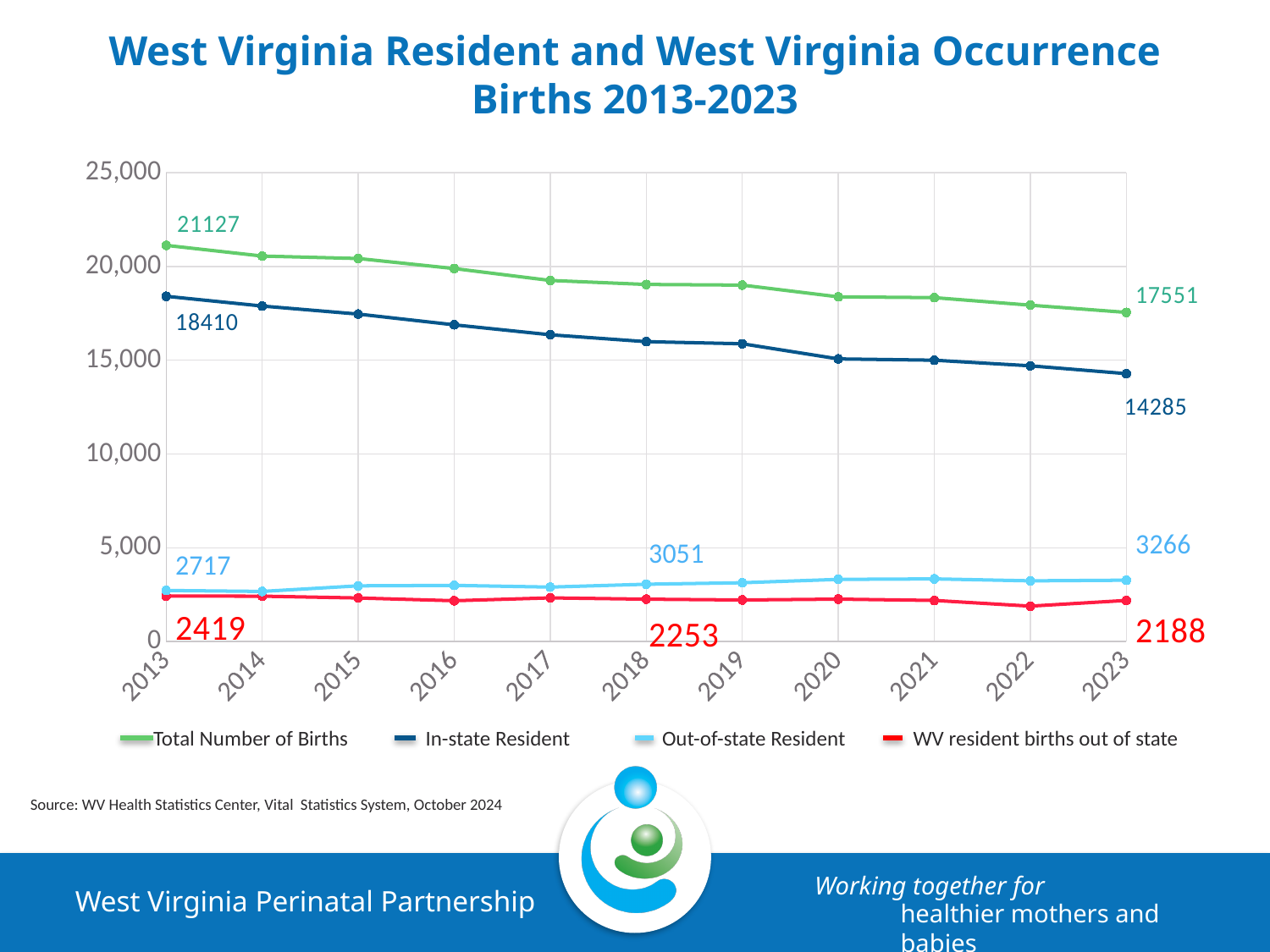
What was the In-state Resident value in 2023? 14285 How many series does the legend list? 4 How many years are plotted on the x axis? 11 What was the Out-of-state Resident value in 2018? 3051 What kind of chart is shown on the slide? line chart Is the Total Number of Births in 2017 greater or less than 20,000? less What was the value for WV resident births out of state in 2023? 2188 Does the Out-of-state Resident line rise or fall from 2013 to 2023? rise By how much did the Total Number of Births decrease from 2013 to 2023? 3576 Does the Total Number of Births rise or fall from 2013 to 2023? fall What was the Total Number of Births in 2013? 21127 What is the difference between the In-state Resident values in 2013 and 2023? 4125